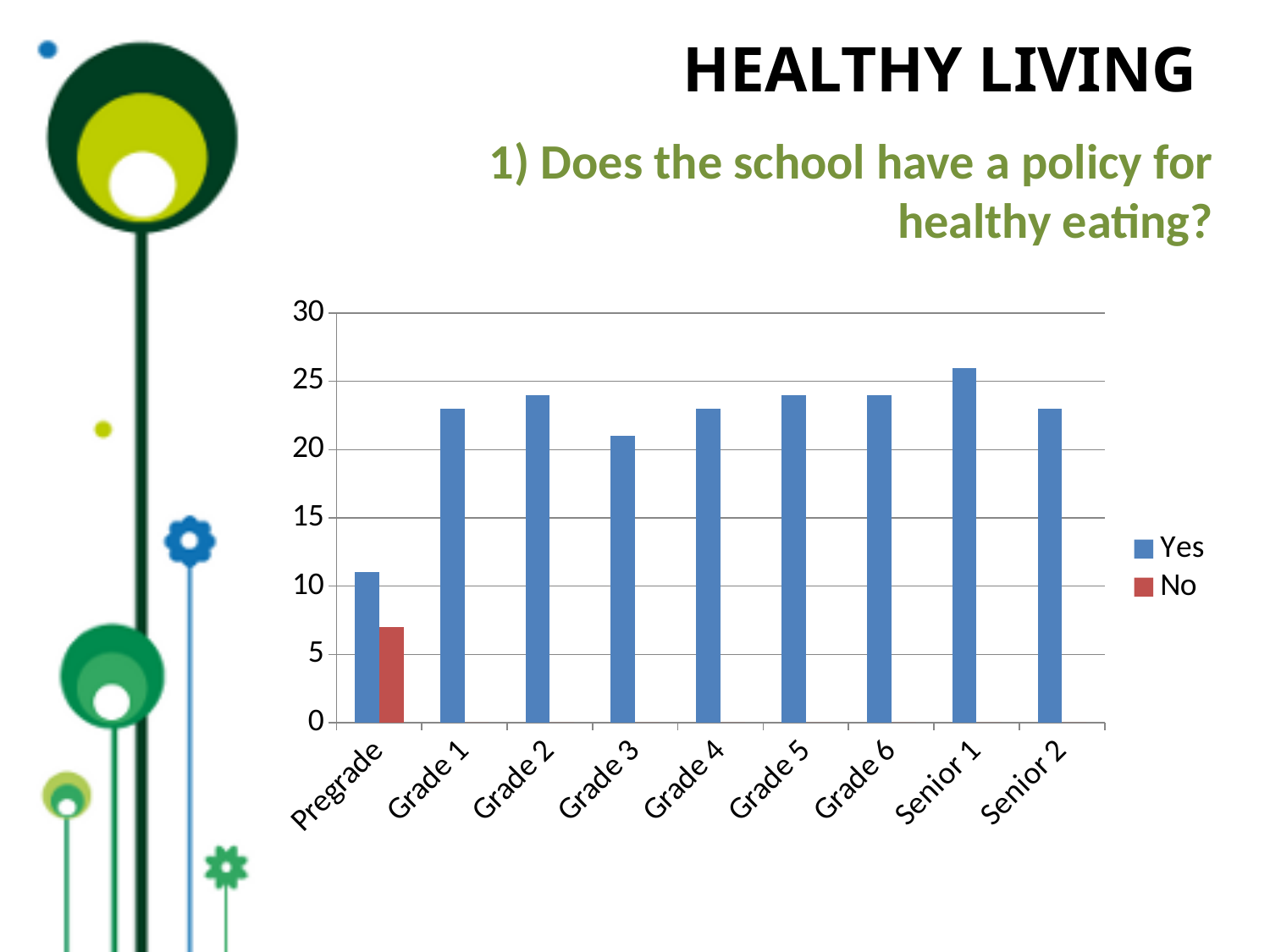
Is the No value for Pregrade greater or less than 10? less Which is larger for Pregrade, the Yes value or the No value? Yes Which is larger, the Yes value for Senior 1 or the Yes value for Grade 3? Senior 1 What kind of chart is shown on the slide? bar chart Which category has the lowest value for the Yes series? Pregrade What are the two entries in the chart's legend? Yes and No Is the Yes value for Senior 2 greater or less than 25? less Which category has the highest value for the Yes series? Senior 1 How many series does the legend list? 2 Is the Yes value for Grade 1 greater or less than 20? greater How many categories are shown on the x axis? 9 Which category is the only one with a visible bar for the No series? Pregrade